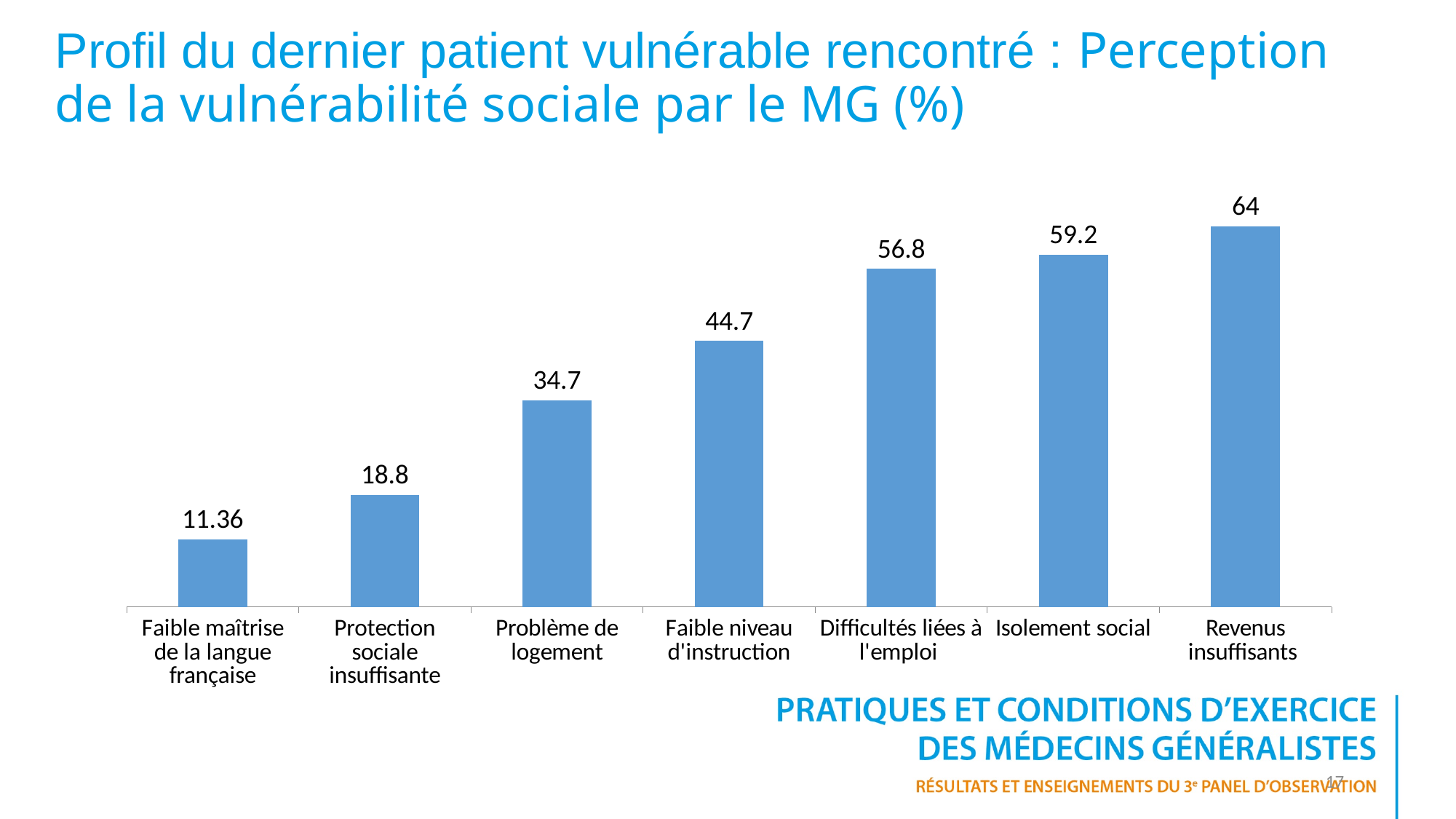
What is the difference between the values for Revenus insuffisants and Isolement social? 4.8 What is the value for Revenus insuffisants? 64 What is the value for Faible maîtrise de la langue française? 11.36 Which category has the lowest value? Faible maîtrise de la langue française Which category has the highest value? Revenus insuffisants How many categories are shown in the chart? 7 Do the values rise or fall from left to right along the x axis? Rise Which is larger, the value for Difficultés liées à l'emploi or the value for Faible niveau d'instruction? Difficultés liées à l'emploi What kind of chart is shown on the slide? Bar chart What is the value for Isolement social? 59.2 What is the difference between the values for Faible niveau d'instruction and Protection sociale insuffisante? 25.9 What is the value for Problème de logement? 34.7